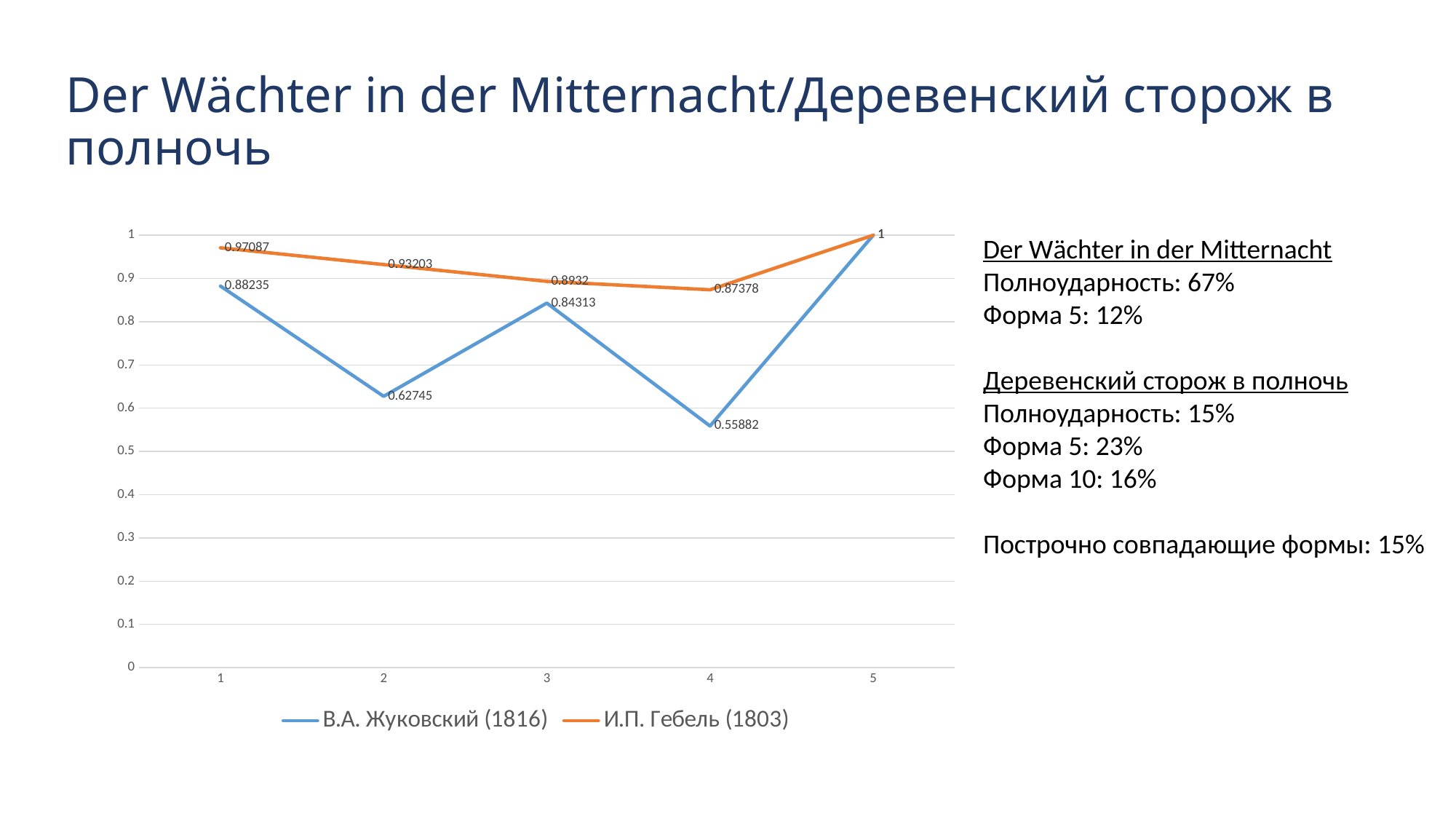
What is the value for В.А. Жуковский (1816) at position 4? 0.55882 How many series does the legend list? 2 Does the value for И.П. Гебель (1803) rise or fall from position 1 to position 4? fall What is the value for В.А. Жуковский (1816) at position 2? 0.62745 What is the value for И.П. Гебель (1803) at position 1? 0.97087 What is the value for И.П. Гебель (1803) at position 3? 0.8932 What type of chart is shown on the slide? line chart Which series has the larger value at position 2, В.А. Жуковский (1816) or И.П. Гебель (1803)? И.П. Гебель (1803) At which position is the value for В.А. Жуковский (1816) lowest? 4 At which position is the value for И.П. Гебель (1803) highest? 5 What is the difference between the values of И.П. Гебель (1803) and В.А. Жуковский (1816) at position 4? 0.31496 How many points are plotted along the x axis for each series? 5